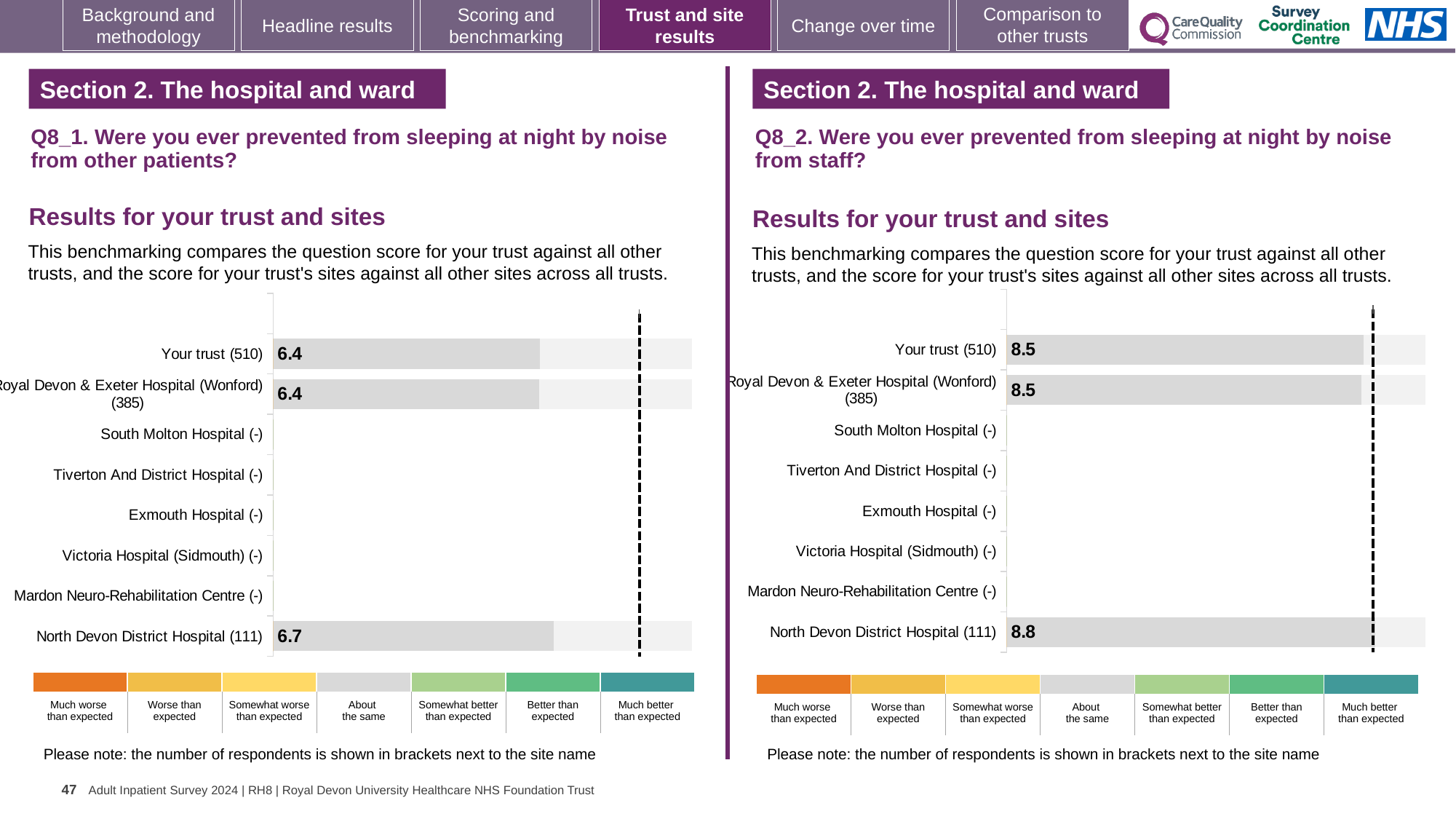
On the Q8_2 chart (right), how many categories does the colour key below the chart list? 7 On the Q8_1 chart (left), how many sites have a score bar plotted? 3 On the Q8_1 chart (left), what is the score for North Devon District Hospital (111)? 6.7 On the Q8_2 chart (right), what is the score for North Devon District Hospital (111)? 8.8 What type of chart is used on the Q8_1 chart (left)? Bar chart On the Q8_2 chart (right), what is the score for Royal Devon & Exeter Hospital (Wonford) (385)? 8.5 On the Q8_2 chart (right), what is the difference between the North Devon District Hospital score and the Your trust score? 0.3 On the Q8_1 chart (left), what is the difference between the North Devon District Hospital score and the Royal Devon & Exeter Hospital (Wonford) score? 0.3 On the Q8_1 chart (left), what is the score for Your trust (510)? 6.4 On the Q8_1 chart (left), which site has the highest score? North Devon District Hospital (111) On the Q8_2 chart (right), how many category rows are listed on the vertical axis? 8 On the Q8_2 chart (right), which is larger: the score for Your trust or the score for North Devon District Hospital? North Devon District Hospital